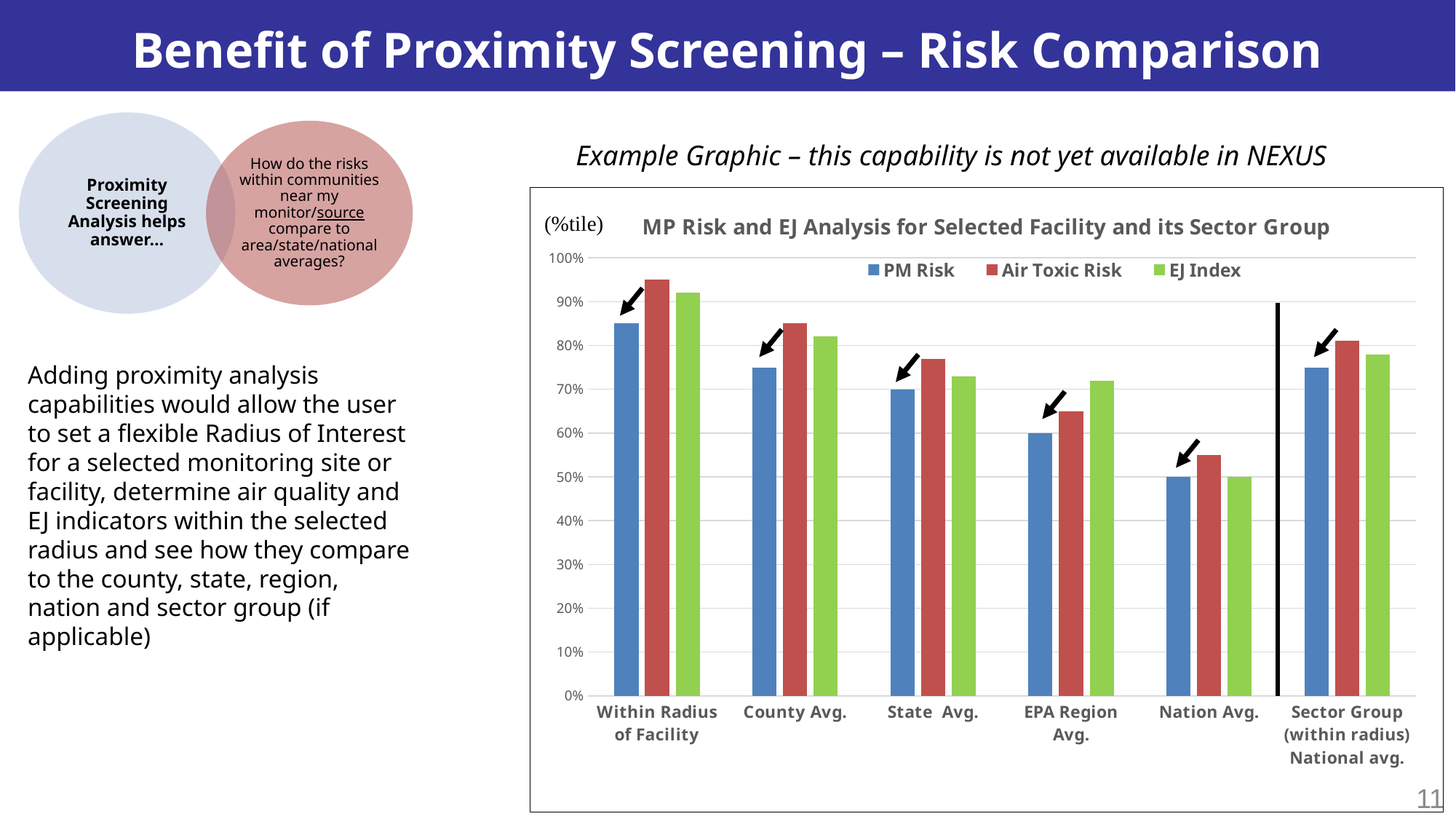
Which category has the highest Air Toxic Risk value? Within Radius of Facility Is the Air Toxic Risk value for Within Radius of Facility greater or less than 90%? greater Which category has the lowest PM Risk value? Nation Avg. What colour represents EJ Index in the chart? green How many series does the chart legend list? 3 Do the PM Risk values rise or fall from Within Radius of Facility to Nation Avg.? fall For EPA Region Avg., which is larger: Air Toxic Risk or EJ Index? EJ Index What is the PM Risk value for Nation Avg.? 50% How many categories are shown along the x axis of the chart? 6 Is the Air Toxic Risk value for Nation Avg. greater or less than 60%? less Is the PM Risk value for Sector Group (within radius) National avg. greater or less than 80%? less What kind of chart is shown on the slide? bar chart